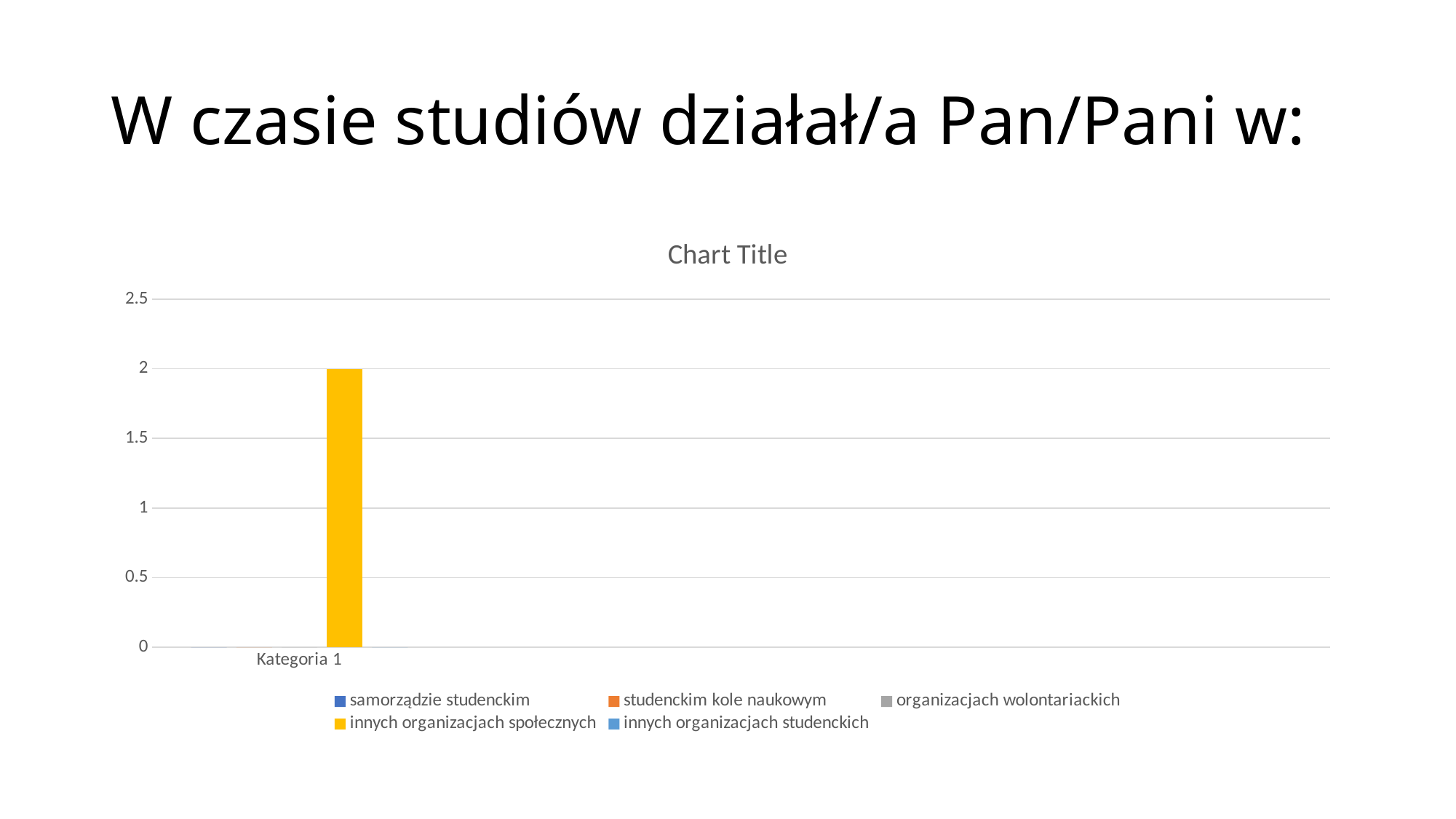
Which series has the highest value in Kategoria 1? innych organizacjach społecznych What is the value of the bar for 'innych organizacjach społecznych' in Kategoria 1? 2 How many categories are shown on the x axis? 1 What is the highest value shown on the y axis? 2.5 What kind of chart is shown on the slide? bar chart Is the value for 'innych organizacjach społecznych' greater or less than 1.5? greater How many series does the legend list? 5 What is the title of the chart? Chart Title Is the value for 'innych organizacjach społecznych' greater or less than 2.5? less What is the label of the only category on the x axis? Kategoria 1 What colour is the bar for 'innych organizacjach społecznych'? yellow